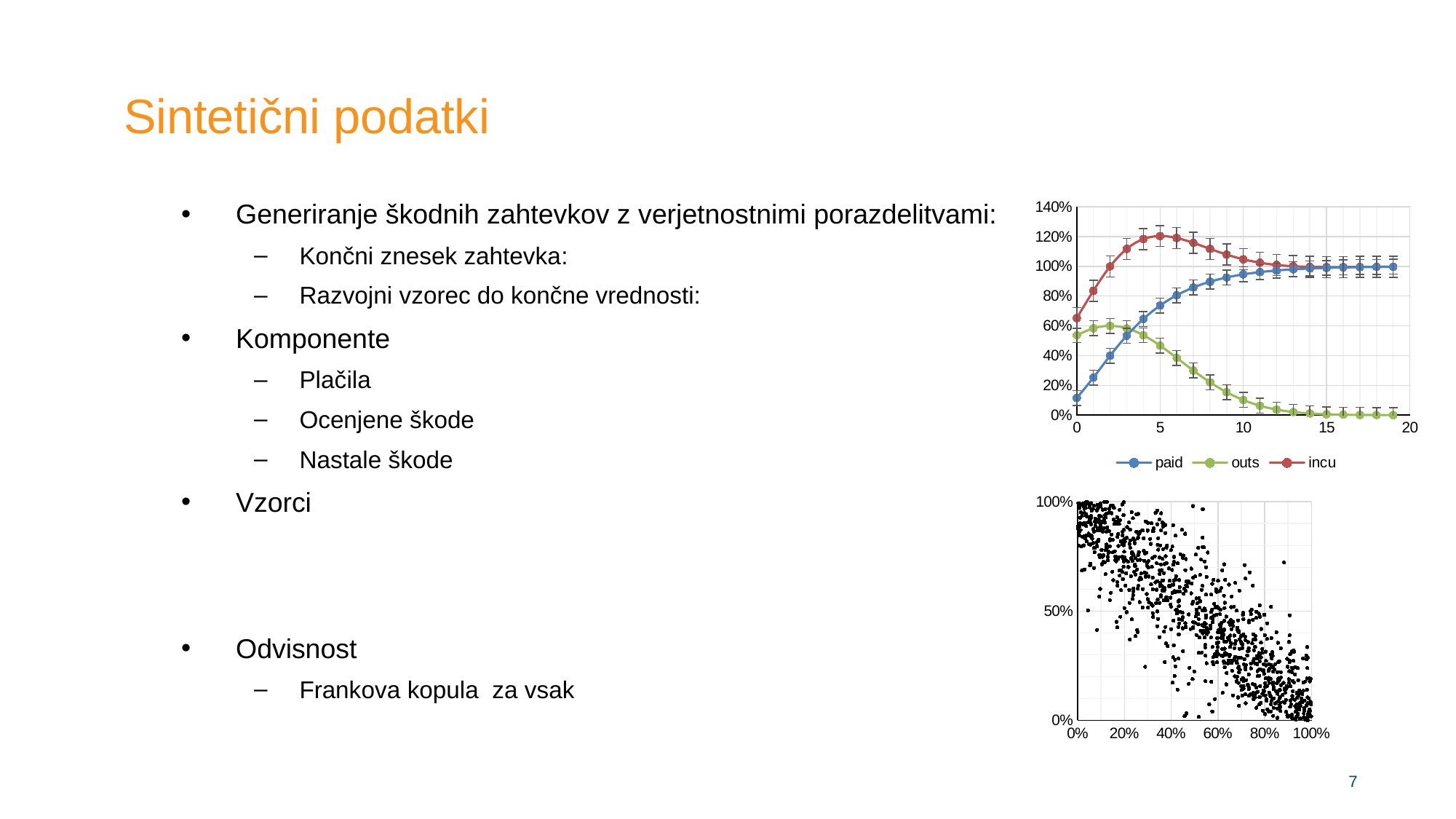
In the top line chart, is the value of the incu series at x = 5 greater or less than 100%? greater What are the names of the series in the legend of the top line chart? paid, outs, incu In the top line chart, does the paid series rise or fall as x increases from 0 to 10? rise In the top line chart, which is larger at x = 0: the incu series or the paid series? incu In the top line chart, which series has the lowest value at x = 15? outs In the top line chart, which series has the highest value at x = 5? incu In the bottom scatter plot, do the y values tend to rise or fall as the x values increase? fall In the top line chart, is the value of the outs series at x = 15 greater or less than 20%? less What kind of chart is the top chart on the right of the slide? line chart What kind of chart is the bottom chart on the right of the slide? scatter plot In the top line chart, is the value of the paid series at x = 0 greater or less than 20%? less How many series does the legend of the top line chart list? 3